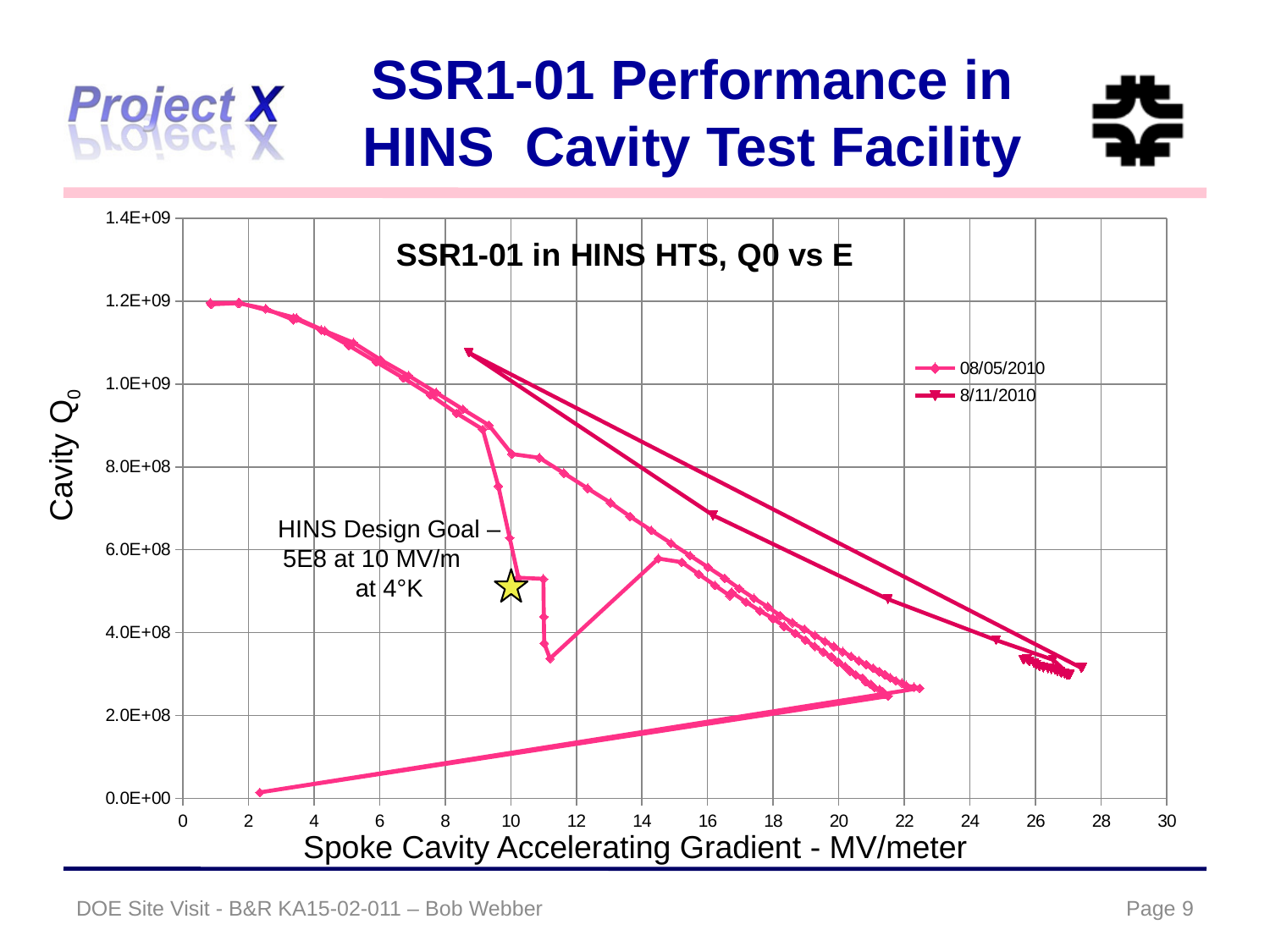
Is the maximum accelerating gradient reached by the 08/05/2010 series greater or less than 24 MV/meter? less What is the title of the chart? SSR1-01 in HINS HTS, Q0 vs E What is the label of the x axis? Spoke Cavity Accelerating Gradient - MV/meter Is the maximum accelerating gradient reached by the 8/11/2010 series greater or less than 26 MV/meter? greater What is the label of the y axis? Cavity Q0 What are the two series named in the legend? 08/05/2010 and 8/11/2010 What is the highest value shown on the x axis? 30 Which series reaches the higher accelerating gradient, 08/05/2010 or 8/11/2010? 8/11/2010 What is the highest value shown on the y axis? 1.4E+09 Overall, does Cavity Q0 rise or fall as the accelerating gradient increases? Fall What kind of chart is shown on the slide? Line chart How many series does the chart legend list? 2